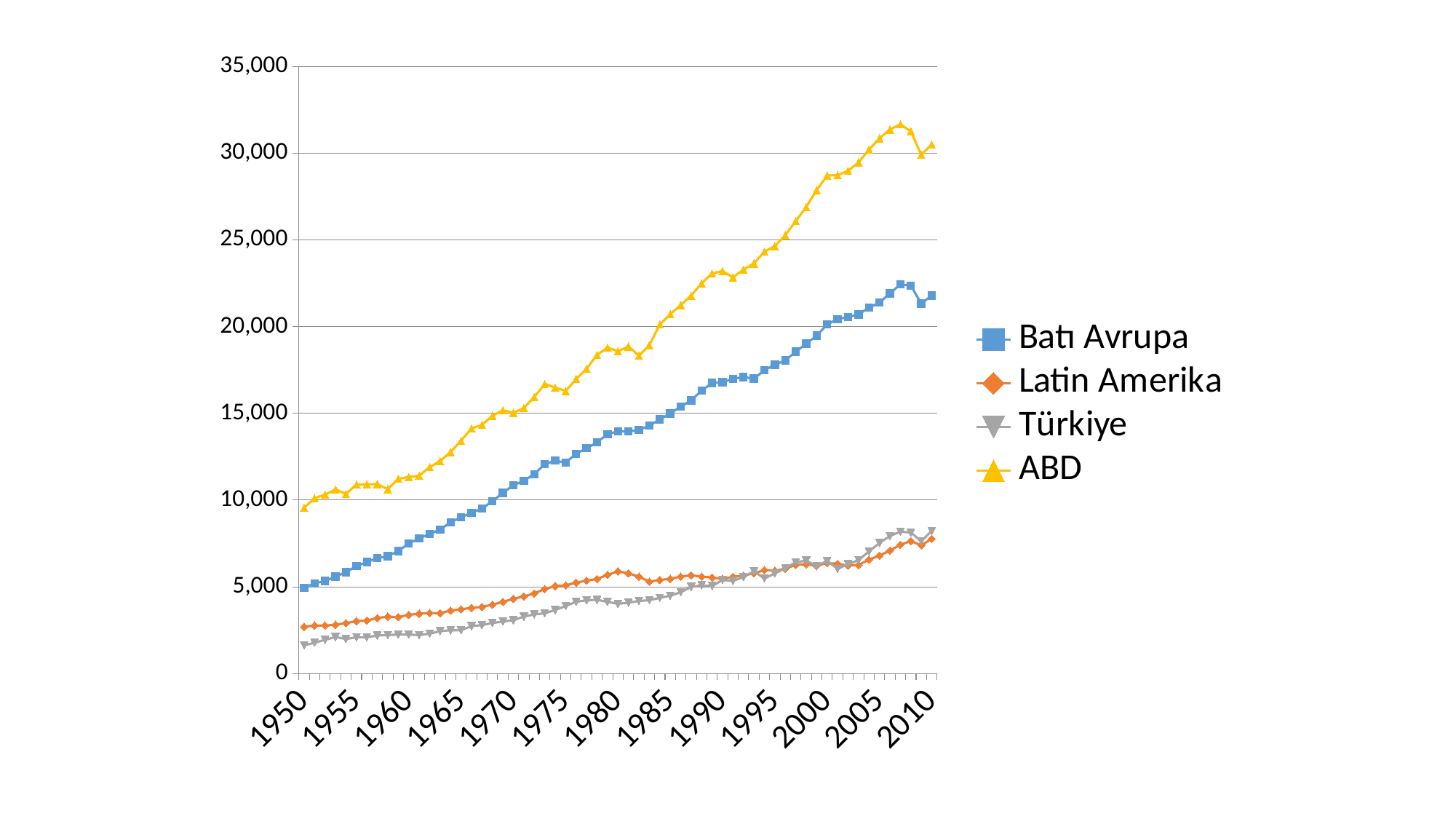
In 2000, which is larger: the value for ABD or the value for Batı Avrupa? ABD What kind of chart is shown on the slide? line chart Is the value for Batı Avrupa in 2010 greater or less than 20,000? greater Is the value for Batı Avrupa in 1980 greater or less than 10,000? greater Is the value for ABD in 1950 greater or less than 10,000? less How many series does the legend list? 4 Which series has the highest values across the whole period shown? ABD Which series has the lowest value in 1950? Türkiye Does the ABD series generally rise or fall from 1950 to 2010? rise Which series is drawn with yellow triangle markers? ABD